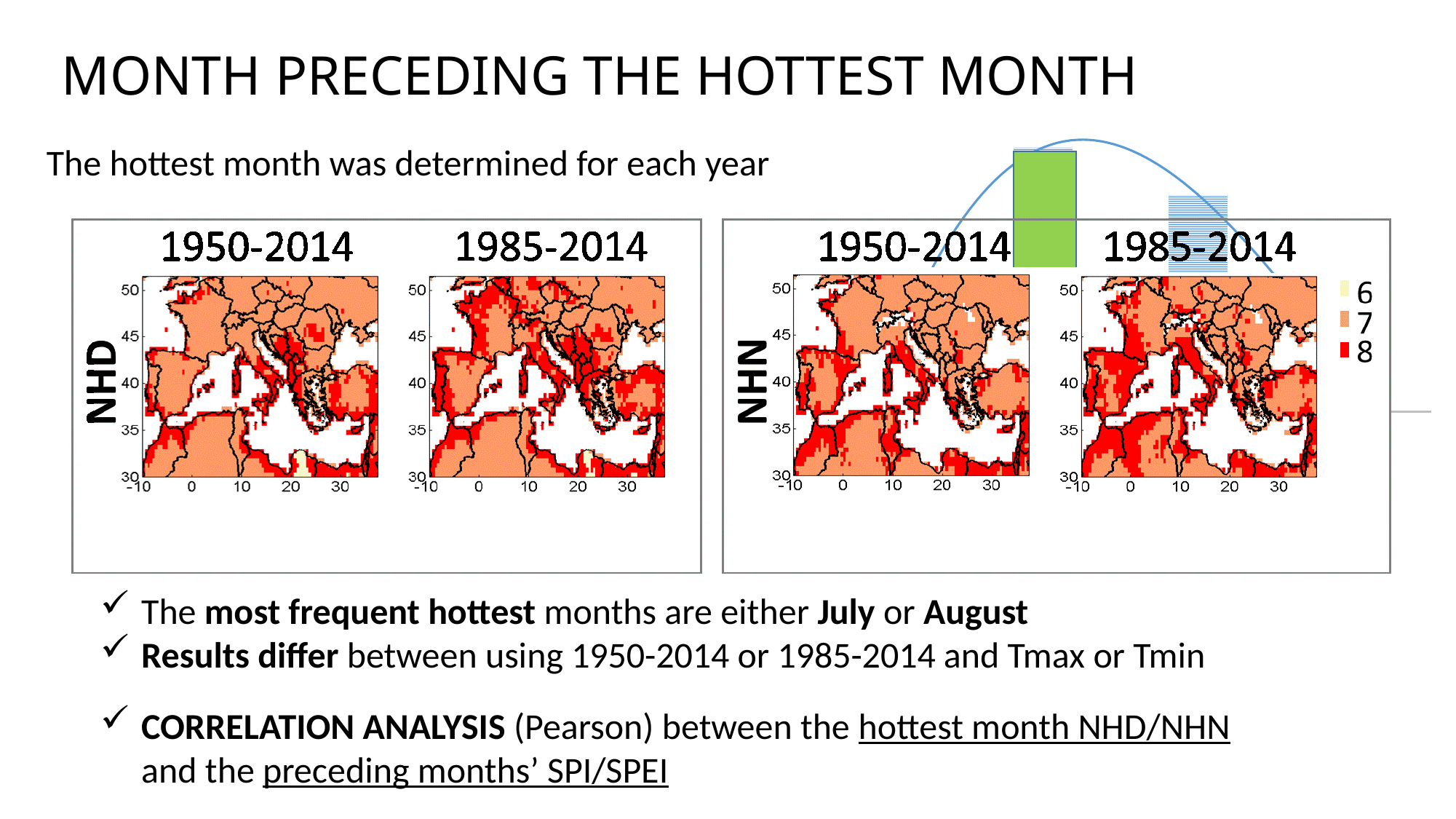
What are the two time periods shown above the maps in the NHD panel? 1950-2014 and 1985-2014 Which value in the legend is represented by the light yellow colour? 6 How many entries does the colour legend on the right list? 3 What is the highest value shown in the legend? 8 How many maps are shown on the slide in total? 4 What label is written vertically on the left of the right-hand panel of maps? NHN Which value in the legend is represented by the red colour? 8 What is the lowest value shown in the legend? 6 How many maps are in the NHD panel? 2